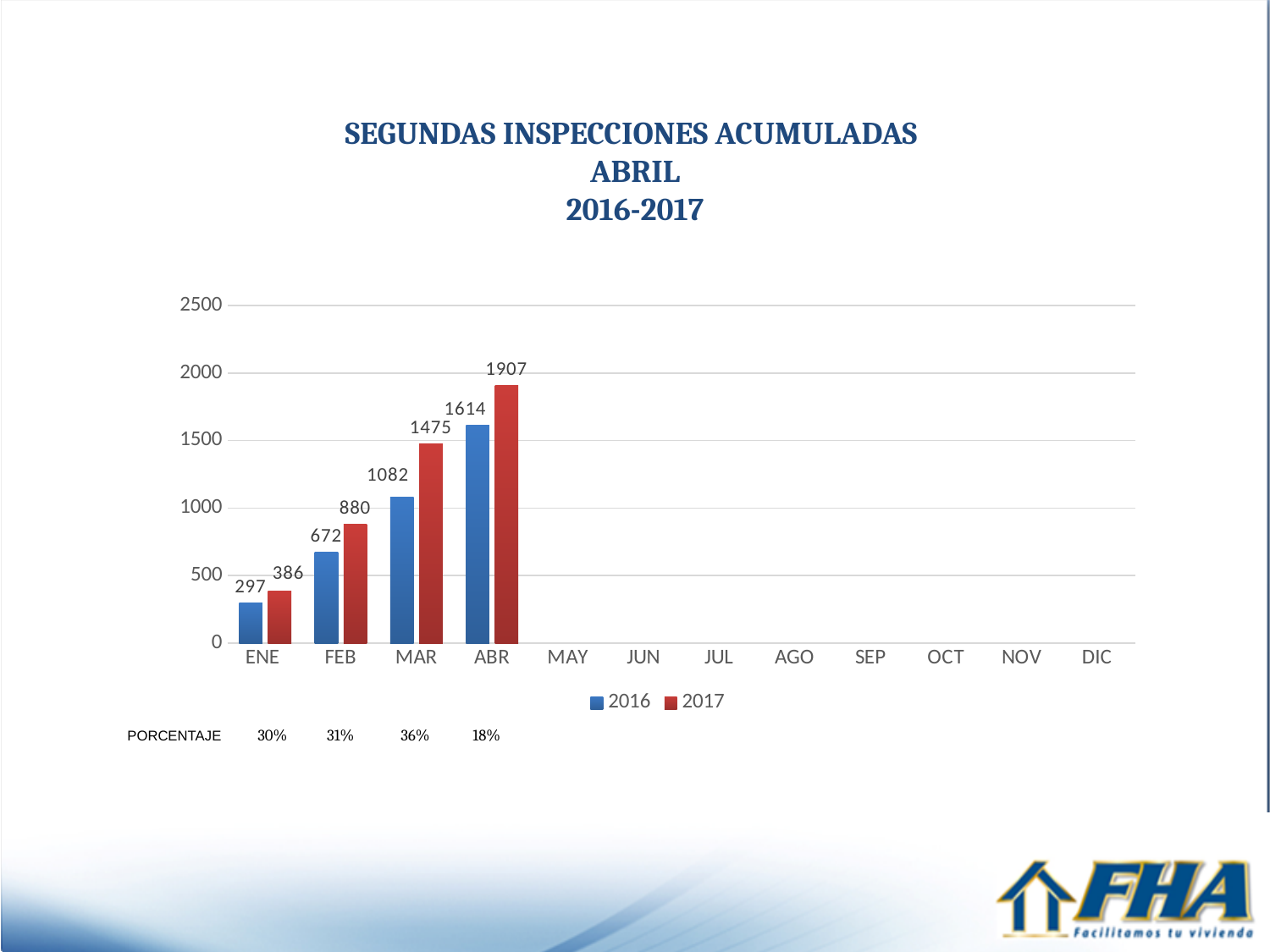
What is the difference between the 2017 and 2016 values in ABR? 293 Is the value for 2016 in ABR greater or less than 1500? greater Which is larger in MAR, the 2016 value or the 2017 value? 2017 Which month has the highest value for the 2017 series? ABR What is the value for 2017 in ABR? 1907 Which month has the lowest value for the 2016 series among the months with data? ENE Do the 2017 values rise or fall from ENE to ABR? rise What is the value for 2017 in MAR? 1475 What is the value for 2016 in ENE? 297 How many series does the legend list? 2 What kind of chart is shown on the slide? bar chart What is the value for 2016 in FEB? 672